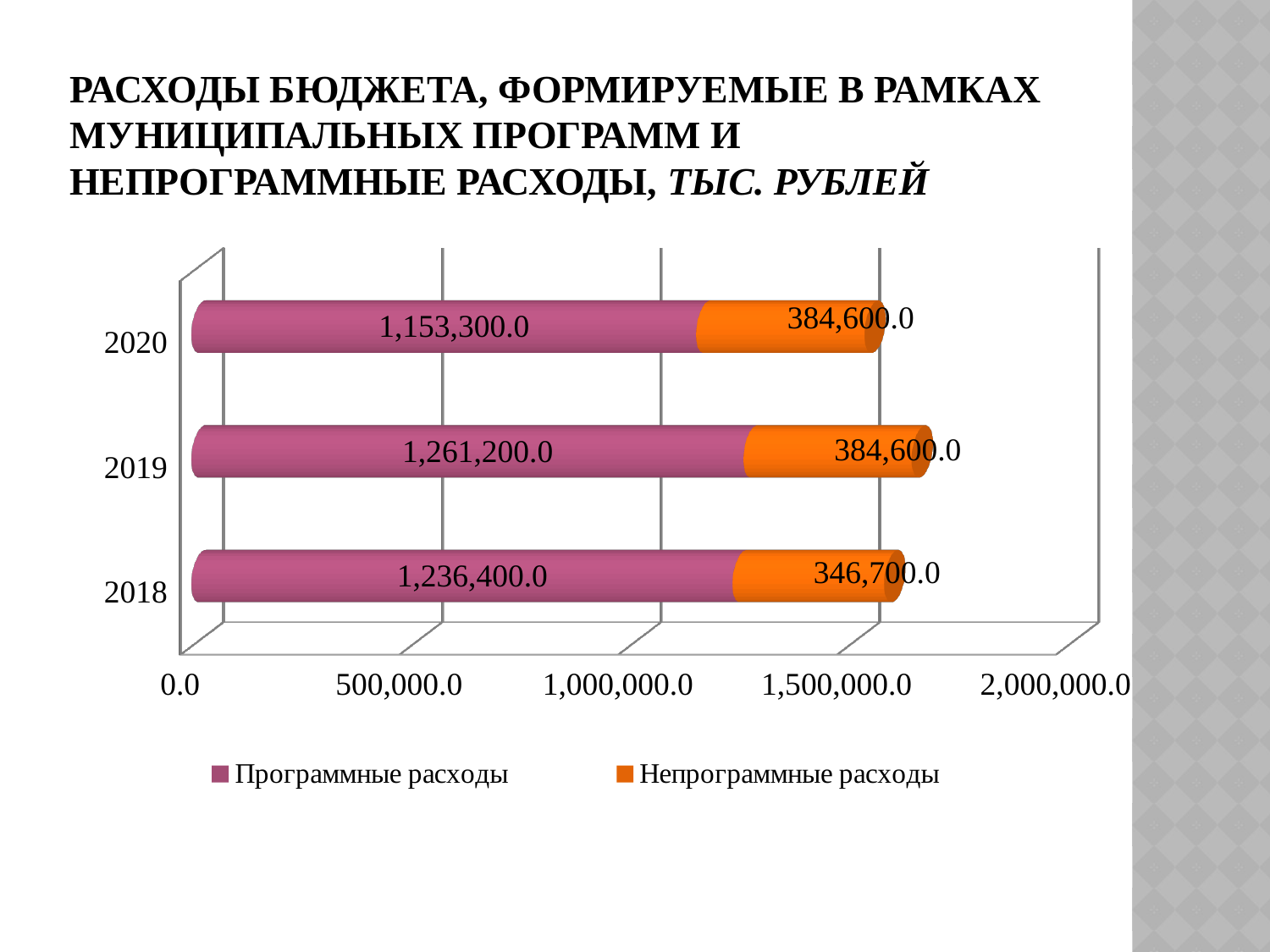
What kind of chart is shown on the slide? Stacked bar chart What is the value of Программные расходы for 2020? 1,153,300.0 What is the difference between Непрограммные расходы in 2019 and in 2018? 37,900.0 How many series does the legend list? 2 Which is larger: Программные расходы in 2018 or in 2020? 2018 Which year has the highest value of Программные расходы? 2019 What is the total of the stacked bar for 2018? 1,583,100.0 What is the difference between Программные расходы in 2019 and in 2020? 107,900.0 What is the value of Непрограммные расходы for 2018? 346,700.0 What is the value of Программные расходы for 2019? 1,261,200.0 How many years are shown on the chart? 3 Which year has the lowest value of Непрограммные расходы? 2018